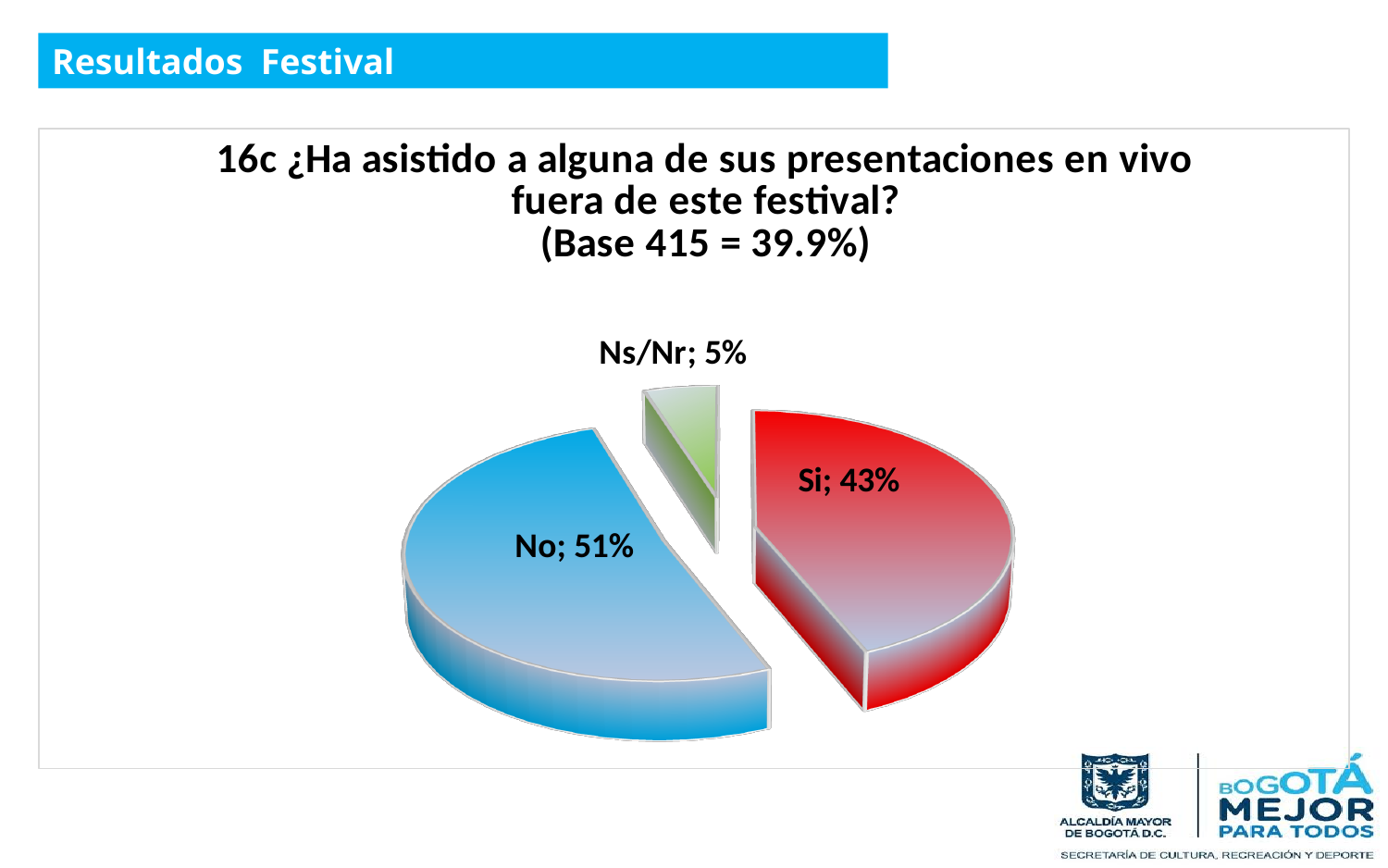
What percentage is shown for "Ns/Nr"? 5% Which category has the smallest share of the pie? Ns/Nr What is the difference in percentage points between "Si" and "Ns/Nr"? 38 What is the base number of respondents stated in the chart title? 415 What is the difference in percentage points between "No" and "Si"? 8 What percentage of respondents answered "No"? 51% How many slices does the pie chart have? 3 Which category has the largest share of the pie? No Which is larger, the share for "Si" or the share for "Ns/Nr"? Si What kind of chart is shown on the slide? Pie chart What colour is the "No" slice of the pie? Blue What percentage of respondents answered "Si"? 43%